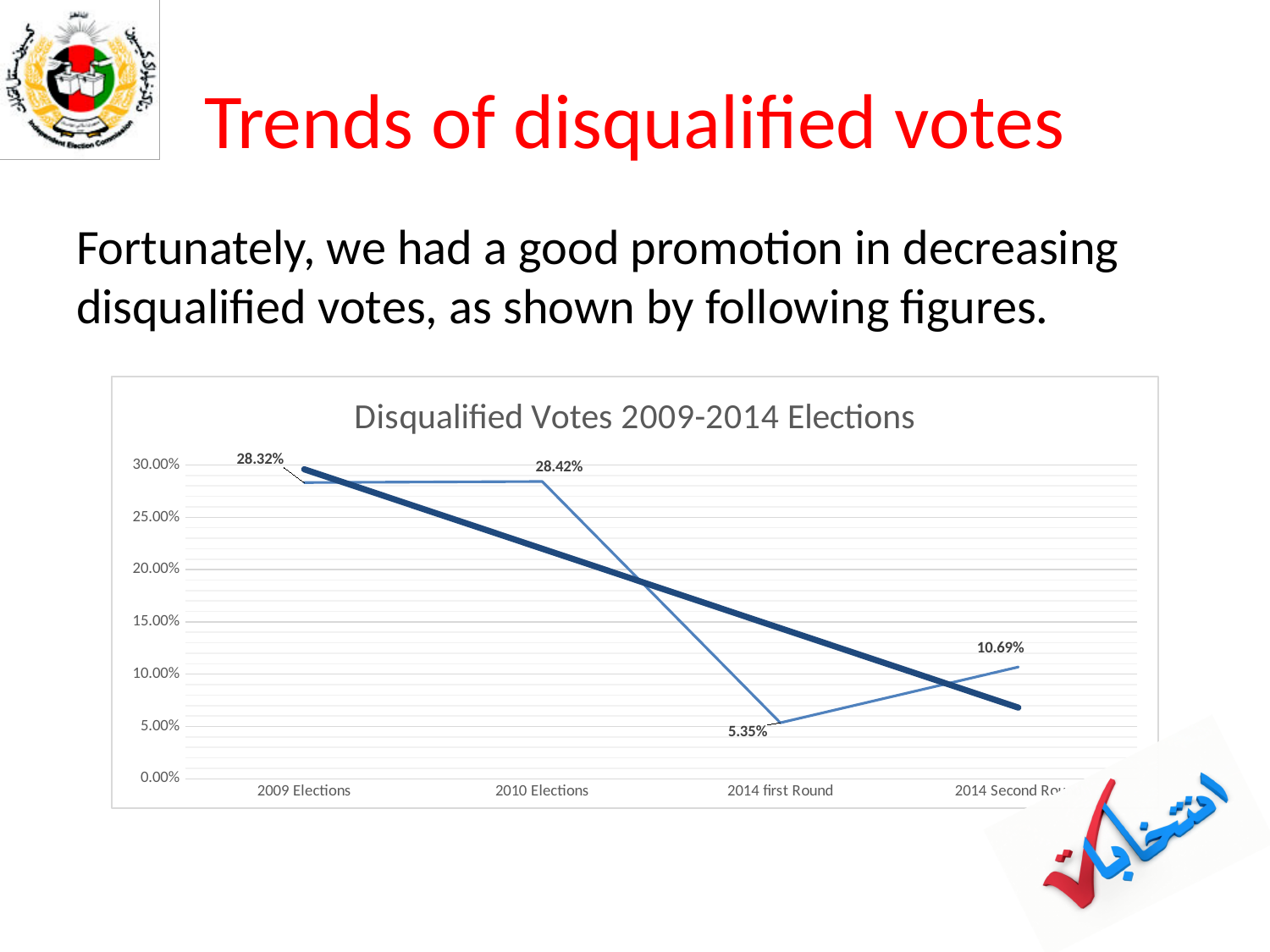
What is the disqualified vote percentage for the 2014 first Round? 5.35% Is the value for the 2010 Elections greater or less than 25.00%? greater What is the disqualified vote percentage for the 2010 Elections? 28.42% What is the disqualified vote percentage for the 2009 Elections? 28.32% What is the difference between the disqualified vote percentage for the 2009 Elections and the last category (2014 Second Round)? 17.63% What is the disqualified vote percentage for the last category on the x axis (2014 Second Round)? 10.69% How many election categories are plotted on the x axis? 4 Which election has the lowest disqualified vote percentage? 2014 first Round What is the title of the chart? Disqualified Votes 2009-2014 Elections Which has a higher disqualified vote percentage, the 2014 first Round or the last category (2014 Second Round)? 2014 Second Round What kind of chart is shown on the slide? Line chart What is the difference between the disqualified vote percentage for the 2010 Elections and the 2014 first Round? 23.07%